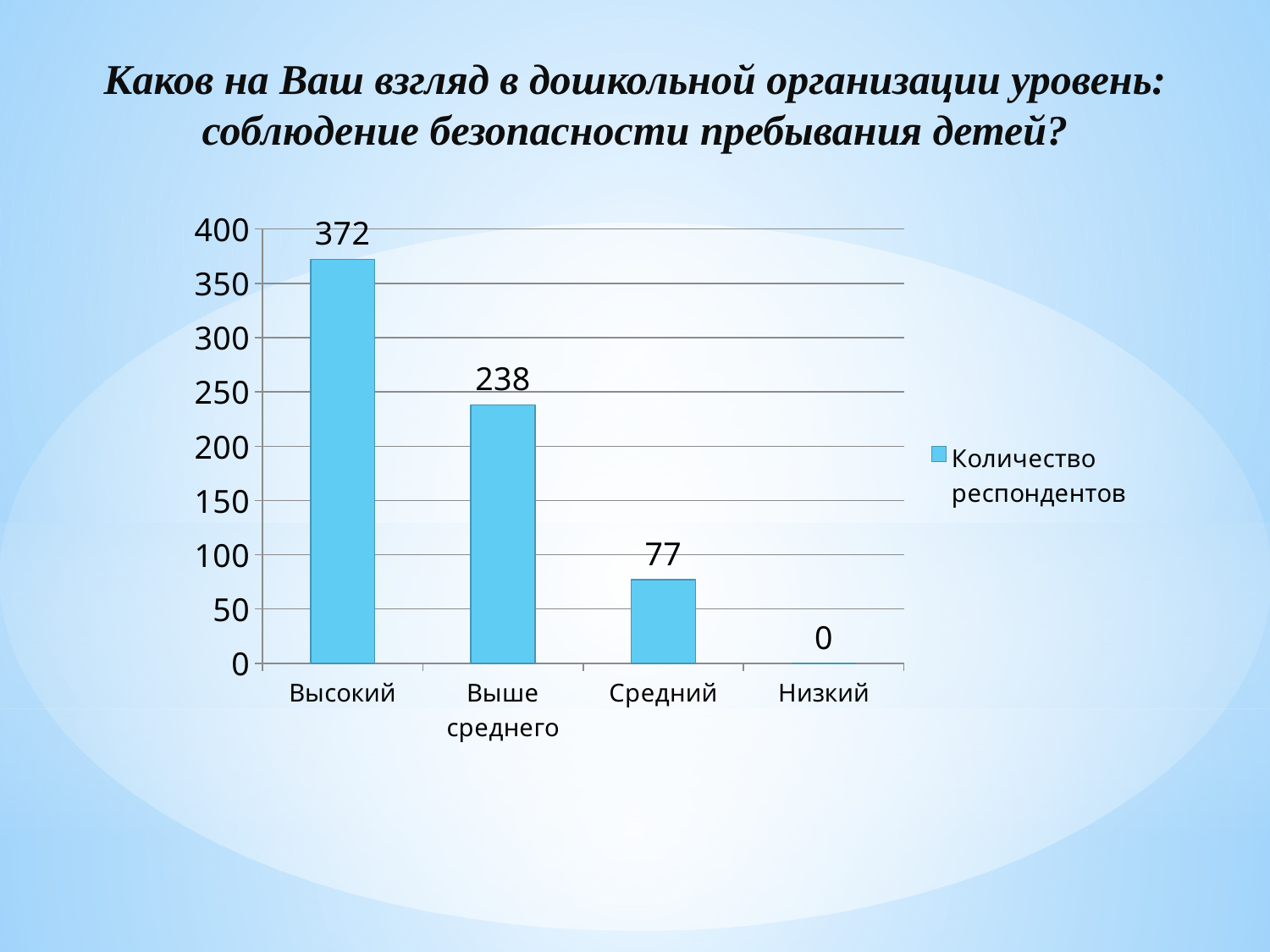
What is the value for Выше среднего? 238 Is the value for Средний greater or less than 100? less Which is larger, the value for Выше среднего or the value for Средний? Выше среднего What is the value for Низкий? 0 What kind of chart is shown on the slide? bar chart What is the value for Высокий? 372 What series name does the legend show? Количество респондентов What is the value for Средний? 77 How many categories are shown on the x axis? 4 Which category has the highest value? Высокий Which category has the lowest value? Низкий What is the difference between the values for Высокий and Выше среднего? 134